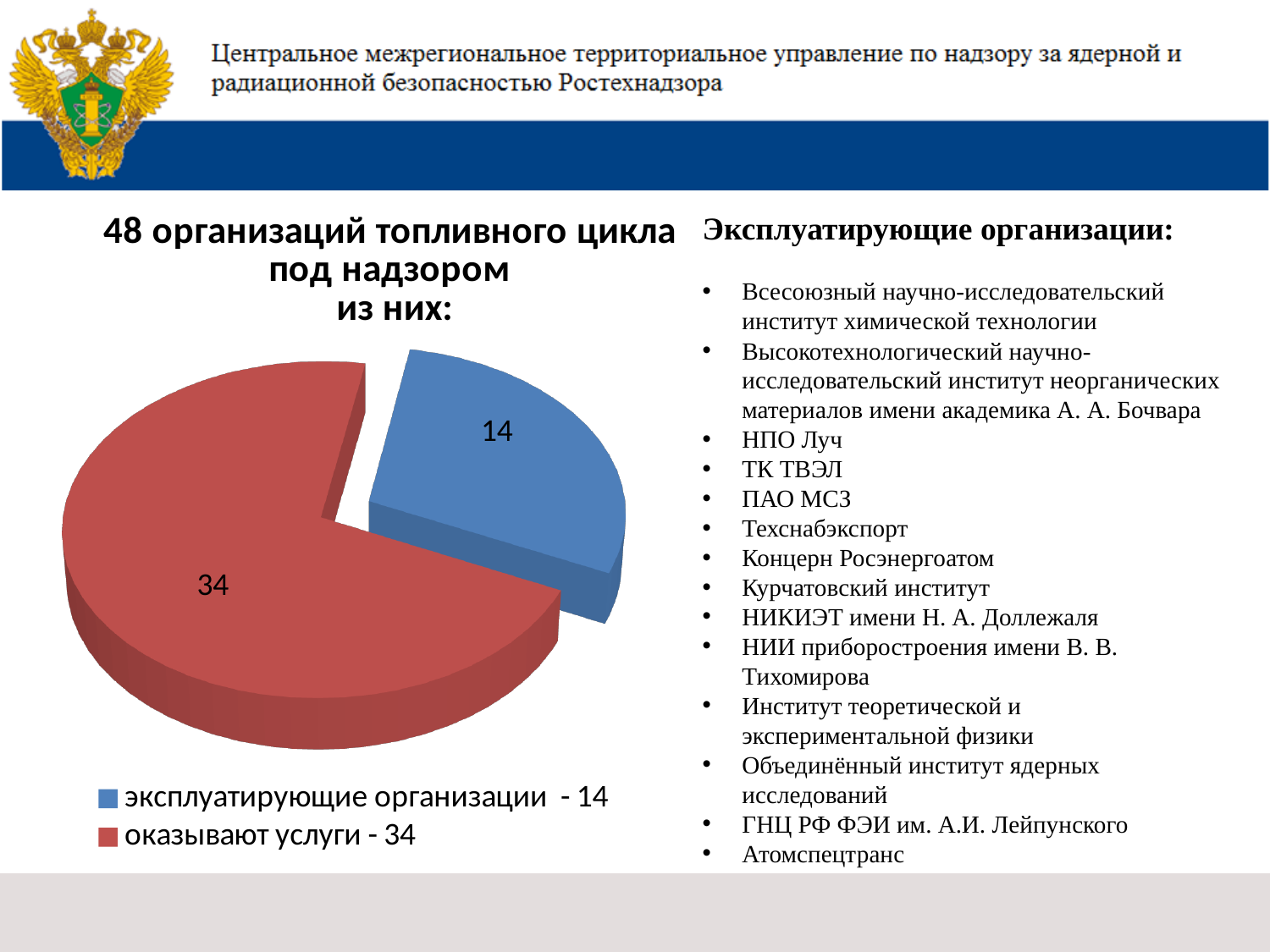
What colour is the slice for 'оказывают услуги'? red Which category has the largest slice in the pie chart? оказывают услуги What is the value for the slice labelled 'оказывают услуги'? 34 What is the value for the slice labelled 'эксплуатирующие организации'? 14 Which category has the smallest slice in the pie chart? эксплуатирующие организации What is the difference between the 'оказывают услуги' value and the 'эксплуатирующие организации' value? 20 How many slices does the pie chart have? 2 What is the title above the pie chart? 48 организаций топливного цикла под надзором из них: Which is larger: 'эксплуатирующие организации' or 'оказывают услуги'? оказывают услуги What type of chart is shown on the slide? pie chart How many entries does the legend list? 2 What is the total of the two slices in the pie chart? 48